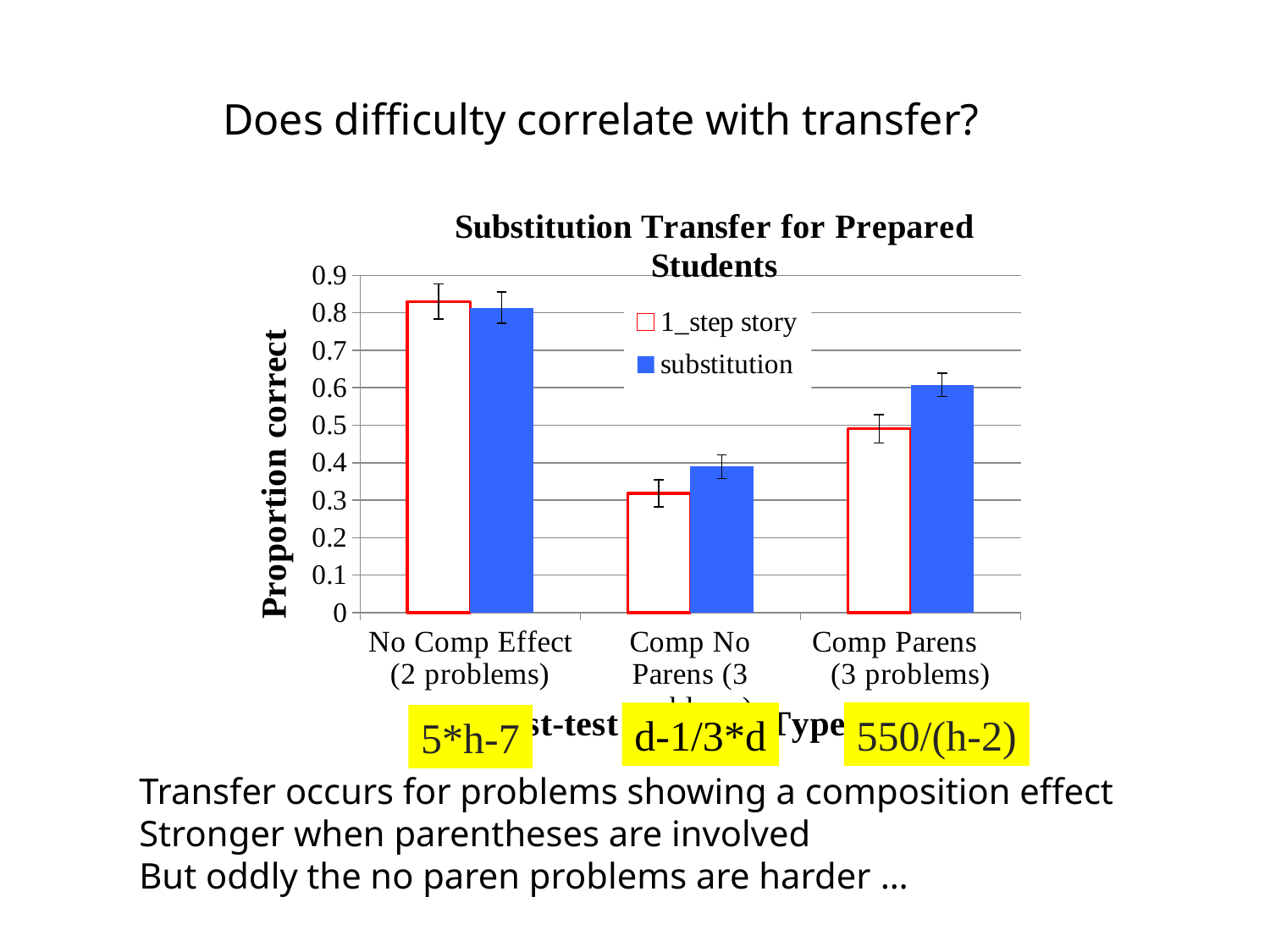
Is the substitution value for Comp Parens (3 problems) greater or less than 0.5? greater What type of chart is shown on the slide? bar chart Is the 1_step story value for Comp No Parens (3 problems) greater or less than 0.4? less For Comp Parens (3 problems), which series has the larger value, 1_step story or substitution? substitution For which category is the 1_step story series lowest? Comp No Parens (3 problems) Is the substitution value for Comp No Parens (3 problems) greater or less than 0.5? less How many categories are shown on the x axis of the chart? 3 What is the label of the vertical axis? Proportion correct How many series does the chart legend list? 2 What is the title of the chart? Substitution Transfer for Prepared Students For which category is the substitution series highest? No Comp Effect (2 problems)